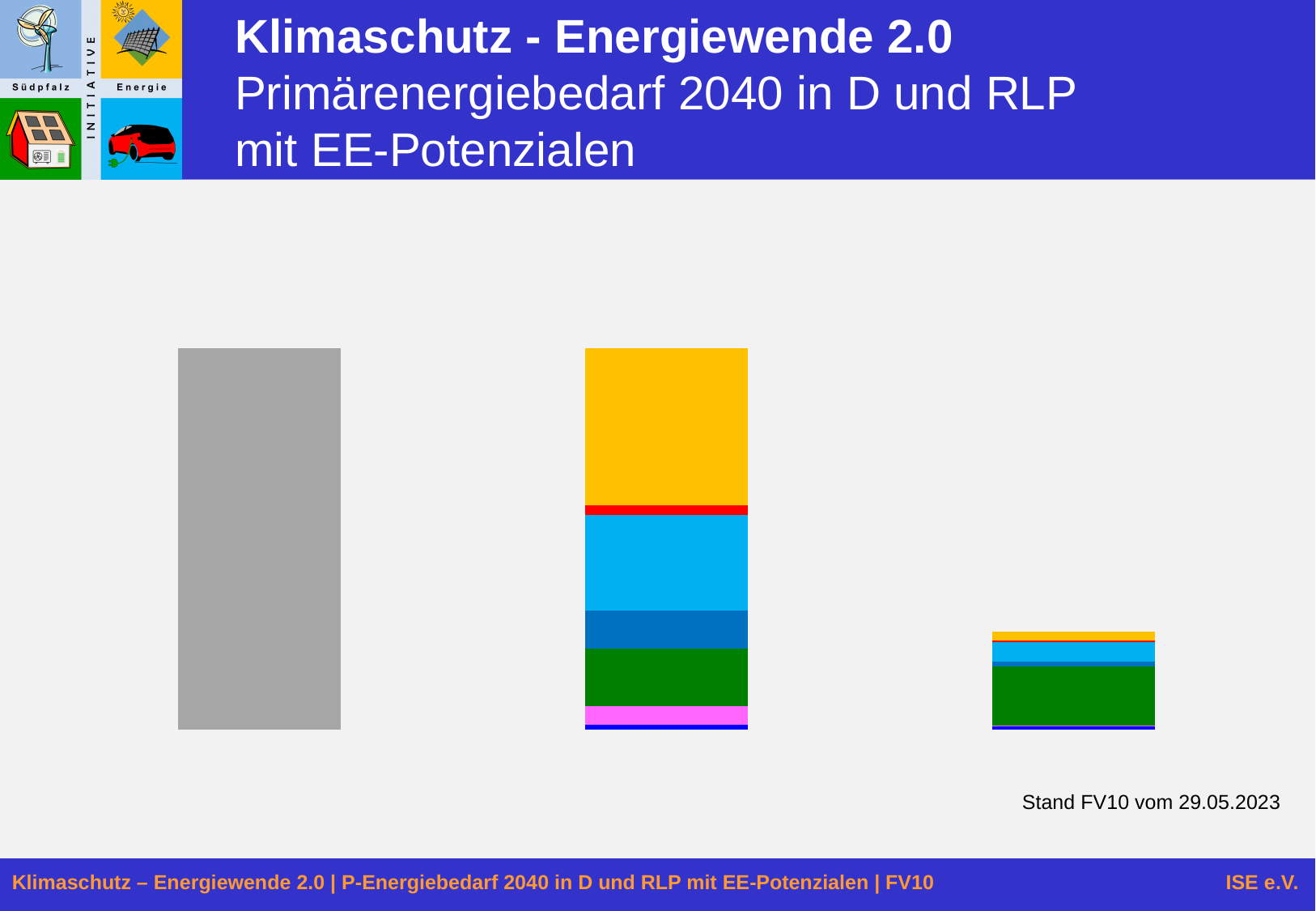
Which bar is the shortest: the left, middle or right one? the right one What kind of chart is shown on the slide? bar chart Which bar is a single solid colour rather than stacked segments: the left, middle or right one? the left one What colour is the leftmost bar? grey Is the middle bar or the right bar taller? the middle bar Is the left bar or the right bar taller? the left bar How many bars are plotted in the chart? 3